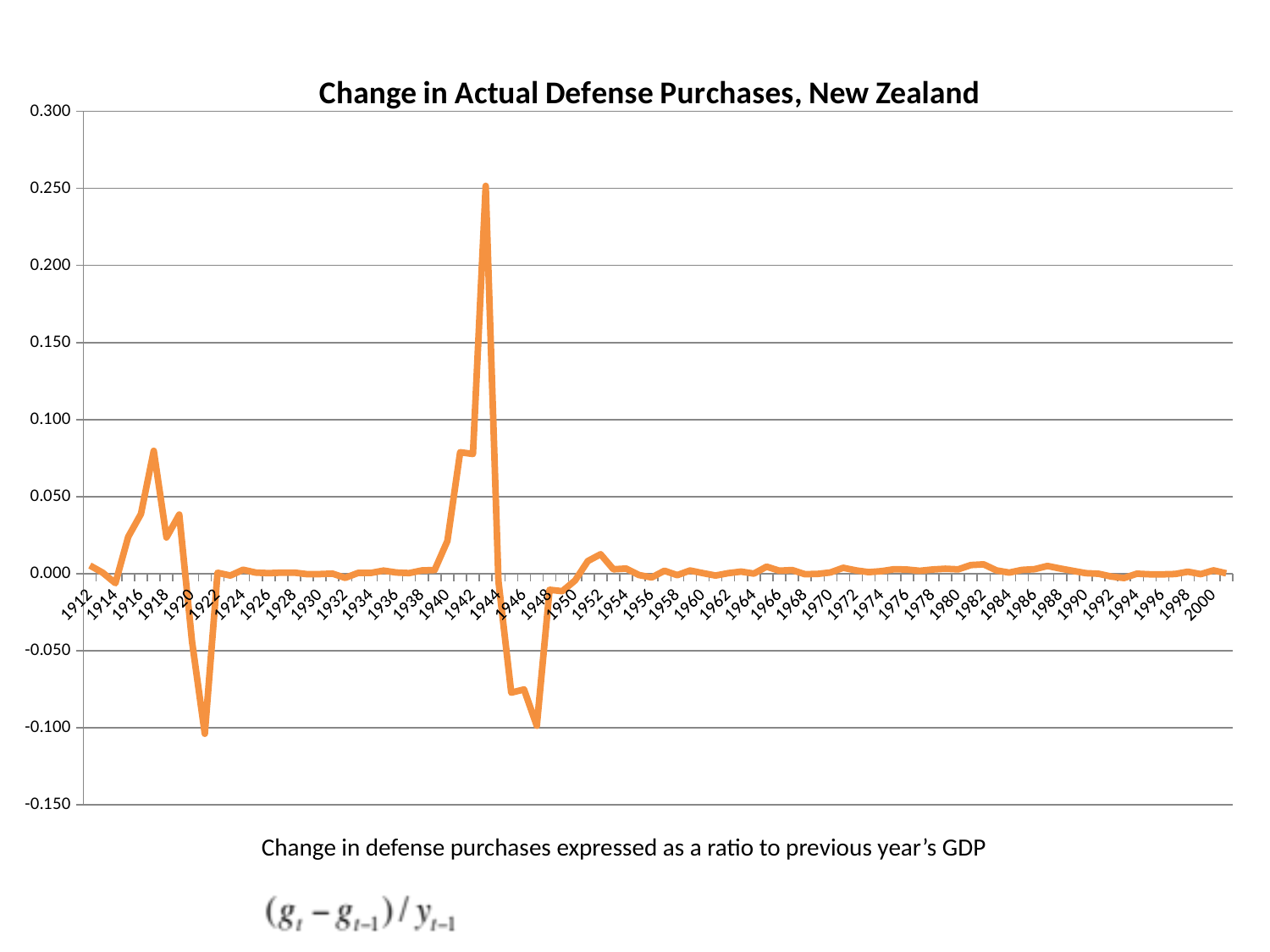
Which year has the larger value, 1943 or 1917? 1943 Is the value for 1921 greater or less than -0.050? less What is the title of the chart? Change in Actual Defense Purchases, New Zealand Is the value for 1941 greater or less than 0.050? greater Is the value for 1917 greater or less than 0.050? greater What kind of chart is shown on the slide? line chart Does the line rise or fall between 1914 and 1917? rise In which year does the line reach its highest value? 1943 Does the line rise or fall between 1943 and 1948? fall